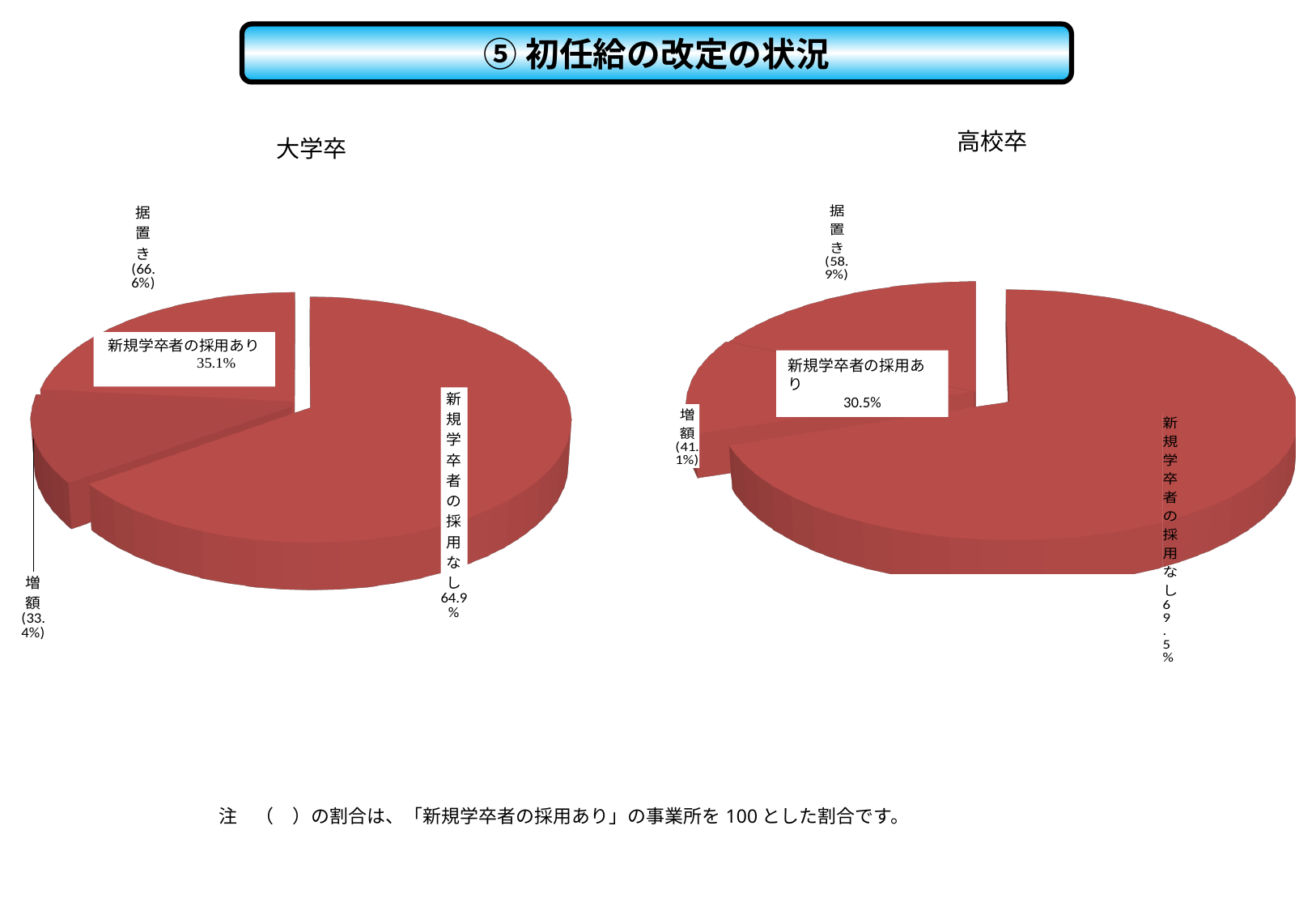
In the 高校卒 chart, what percentage is shown for 新規学卒者の採用あり? 30.5% In the 大学卒 chart, what value in parentheses is shown for 増額? 33.4% What is the difference between 新規学卒者の採用なし and 新規学卒者の採用あり in the 大学卒 chart? 29.8% In the 大学卒 chart, what value in parentheses is shown for 据置き? 66.6% In the 高校卒 chart, what value in parentheses is shown for 増額? 41.1% In the 大学卒 chart, what percentage is shown for 新規学卒者の採用あり? 35.1% In the 高校卒 chart, what percentage is shown for 新規学卒者の採用なし? 69.5% What kind of chart is used for 大学卒 and 高校卒 on this slide? Pie chart In the 高校卒 chart, what value in parentheses is shown for 据置き? 58.9% How many pie charts are shown on the slide? 2 In the 大学卒 chart, what percentage is shown for 新規学卒者の採用なし? 64.9% Which is larger: 新規学卒者の採用なし in the 大学卒 chart or in the 高校卒 chart? 高校卒